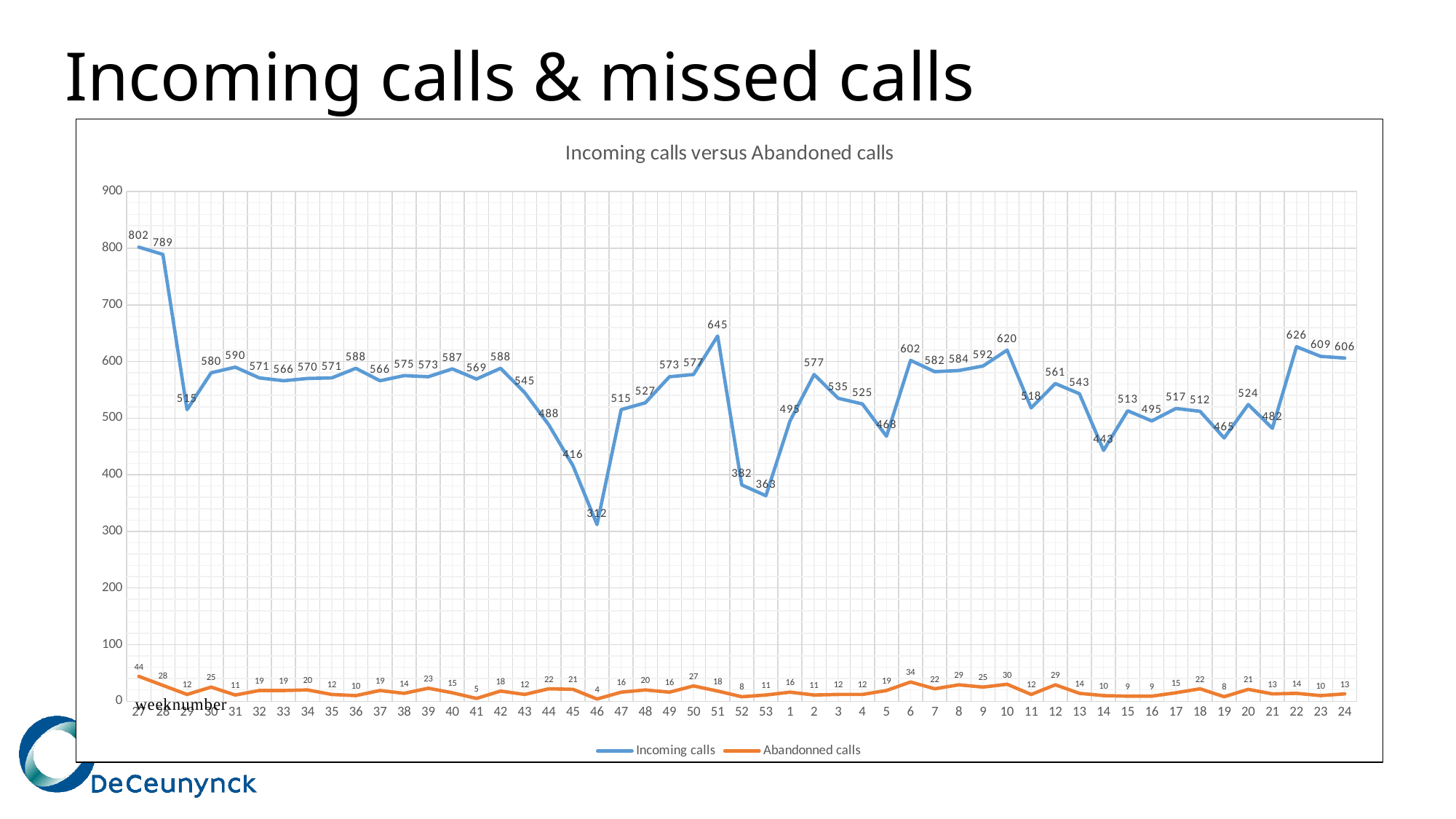
What is the value of Abandonned calls in week 46? 4 In which week are Incoming calls lowest? Week 46 What kind of chart is shown on the slide? Line chart What is the value of Incoming calls in week 51? 645 What is the difference between Incoming calls in week 22 and week 21? 144 In which week are Incoming calls highest? Week 27 Is the value for Incoming calls in week 46 greater or less than 400? less How many series does the legend list? 2 What is the value of Abandonned calls in week 6? 34 Which week has more Incoming calls, week 51 or week 10? Week 51 What is the title of the chart? Incoming calls versus Abandoned calls What is the difference between Incoming calls in week 27 and week 28? 13